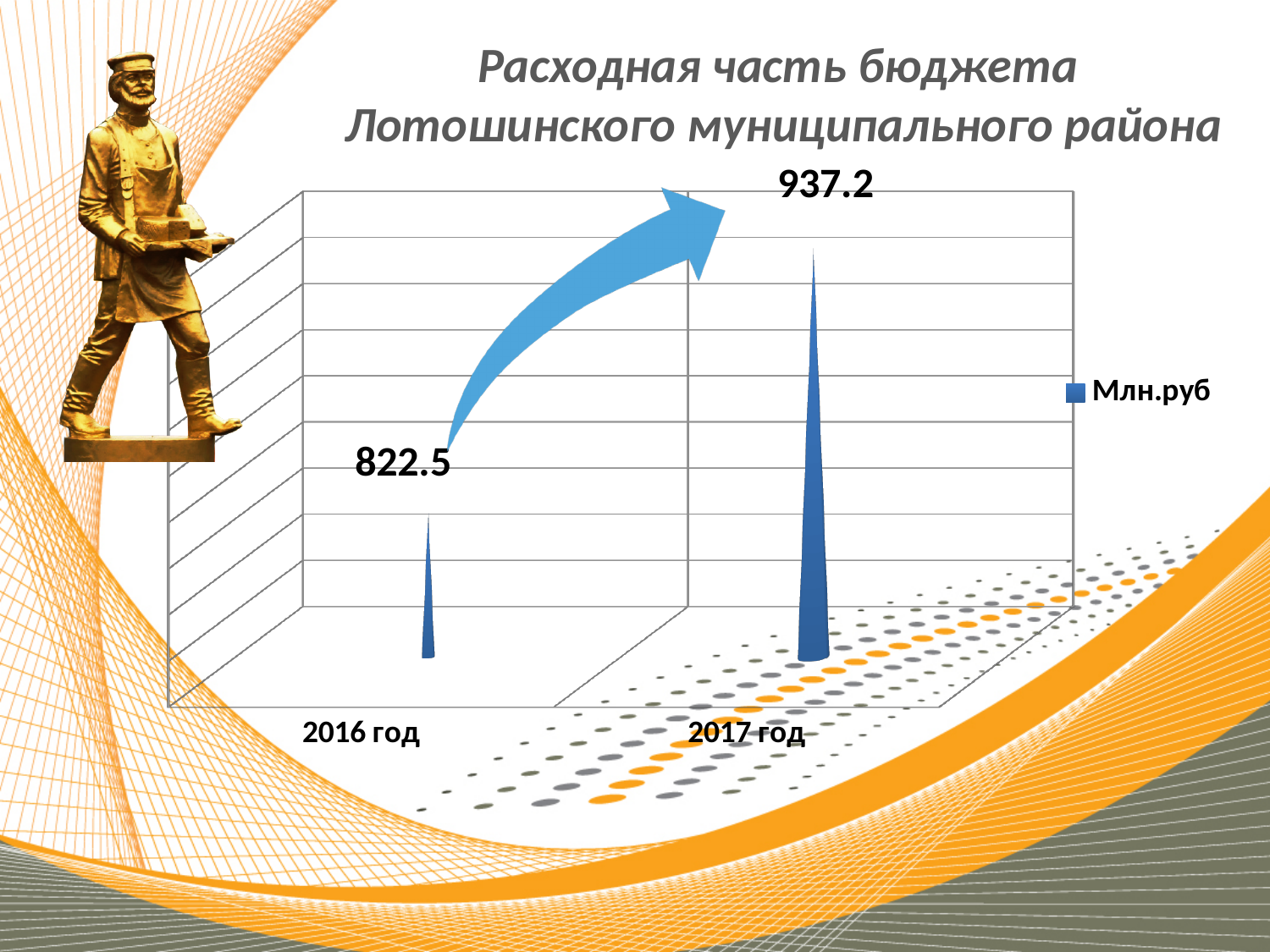
What kind of chart is shown on the slide? Bar chart How many categories are shown on the chart? 2 What series name is shown in the legend? Млн.руб What is the difference between the values for 2017 год and 2016 год? 114.7 How many series does the legend list? 1 Do the values rise or fall from 2016 год to 2017 год? Rise What is the title of the chart? Расходная часть бюджета Лотошинского муниципального района Which year has the highest value? 2017 год What is the value for 2017 год? 937.2 Which year has the lowest value? 2016 год What is the value for 2016 год? 822.5 Which is larger, the value for 2016 год or the value for 2017 год? 2017 год